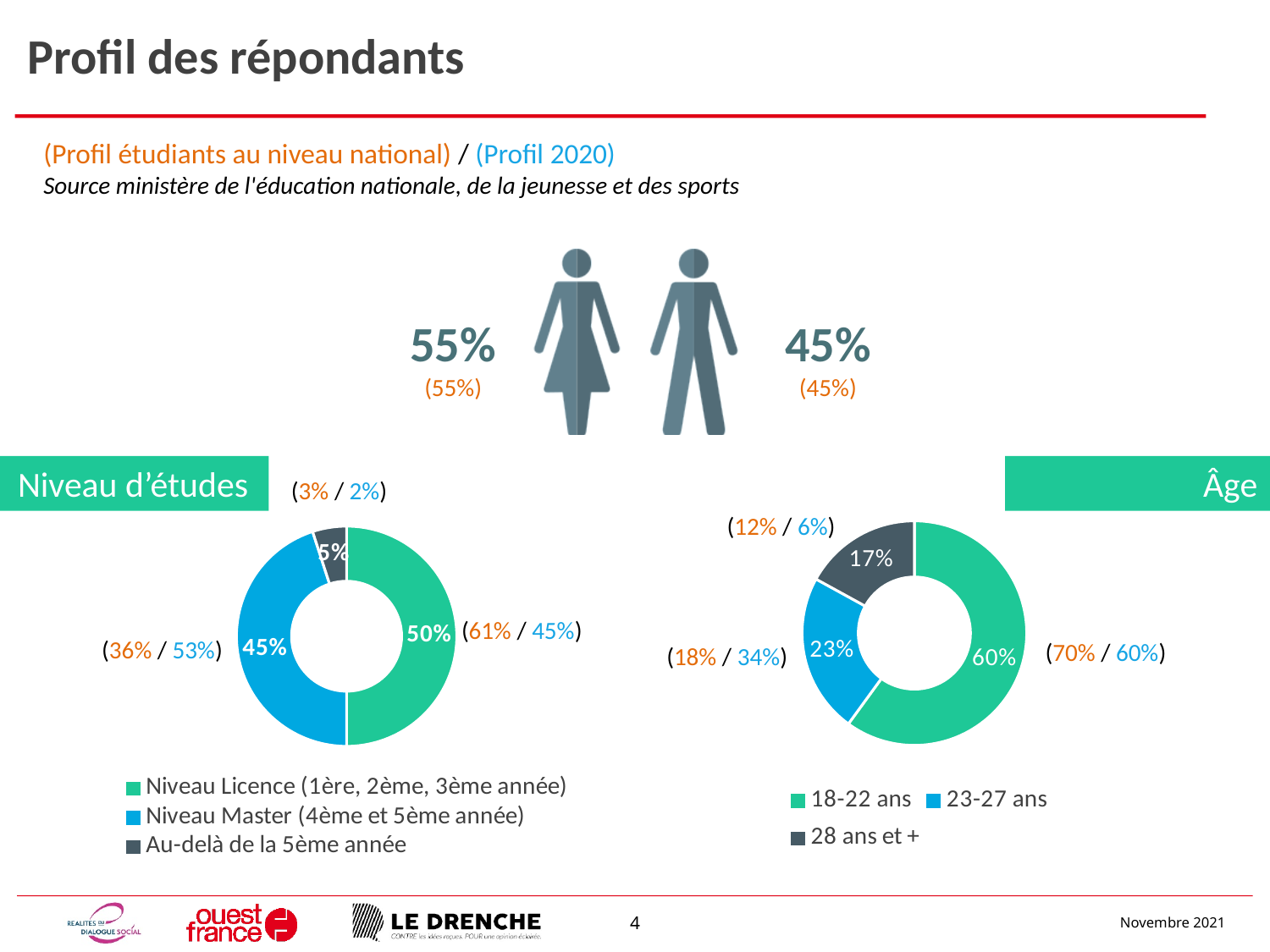
In the 'Niveau d'études' chart, what share is shown for Au-delà de la 5ème année? 5% In the 'Âge' chart, what is the difference between the 23-27 ans share and the 28 ans et + share? 6% How many categories does the legend of the 'Âge' chart list? 3 In the 'Âge' chart, what share is shown for 23-27 ans? 23% In the 'Niveau d'études' chart, what share is shown for Niveau Master (4ème et 5ème année)? 45% In the 'Âge' chart, what share is shown for 28 ans et +? 17% In the 'Âge' chart, which age group has the largest share? 18-22 ans What kind of chart is the 'Niveau d'études' chart? Doughnut chart In the 'Âge' chart, what share is shown for 18-22 ans? 60% In the 'Niveau d'études' chart, what share is shown for Niveau Licence (1ère, 2ème, 3ème année)? 50% In the 'Niveau d'études' chart, what is the difference between the Niveau Licence share and the Niveau Master share? 5% In the 'Niveau d'études' chart, which category has the smallest share? Au-delà de la 5ème année